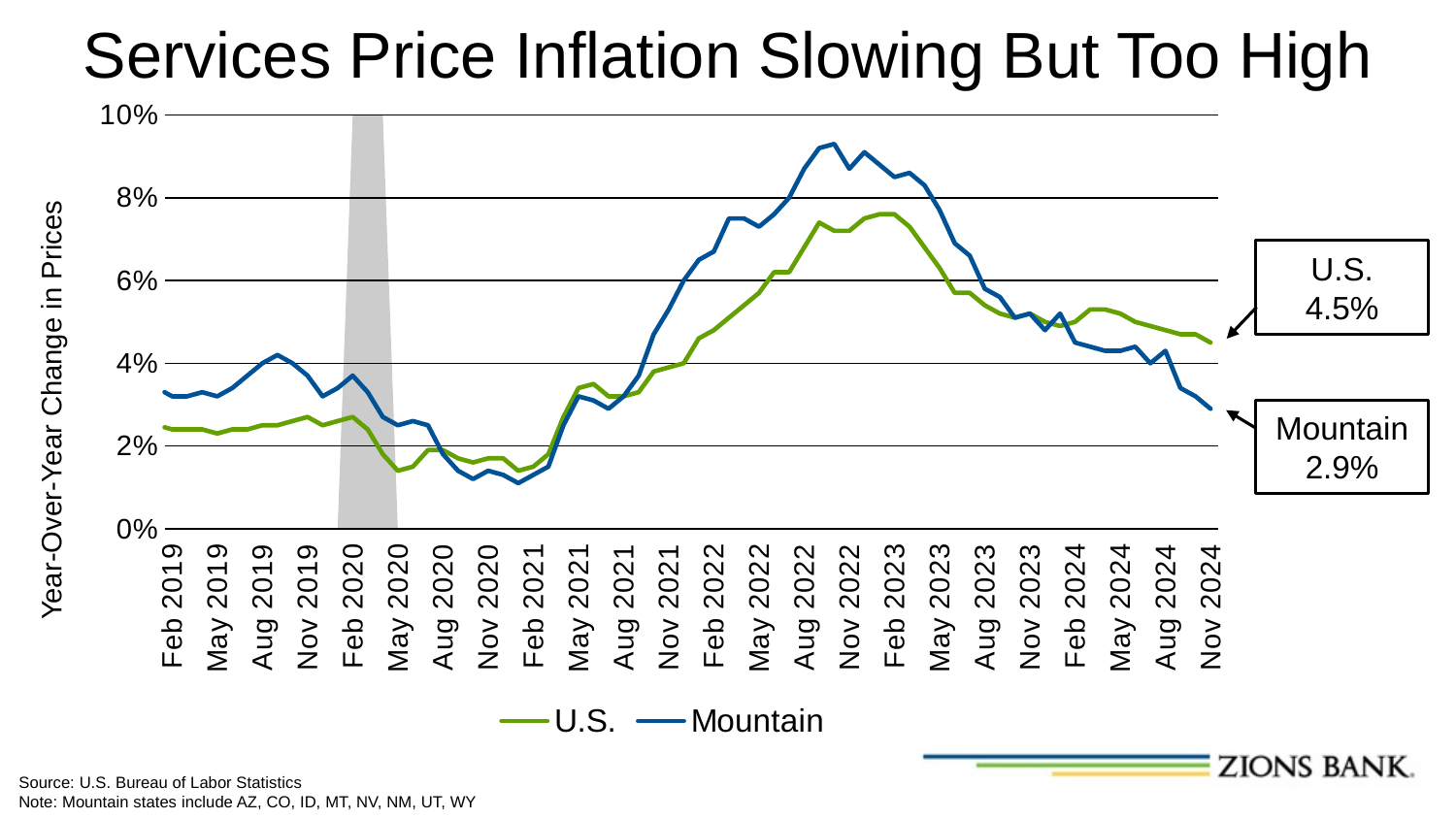
What is the Mountain year-over-year services price inflation value labeled for Nov 2024? 2.9% What kind of chart is shown on the slide? Line chart Is the peak value of the U.S. series greater or less than 8%? less What is the difference between the labeled U.S. value (4.5%) and the labeled Mountain value (2.9%) at Nov 2024? 1.6 percentage points Is the value for the Mountain series in Nov 2020 greater or less than 2%? less Which series reached the higher peak over the period shown, U.S. or Mountain? Mountain How many series does the legend list? 2 From Feb 2023 to Nov 2024, does the Mountain series generally rise or fall? Fall Is the peak value of the Mountain series greater or less than 8%? greater What is the U.S. year-over-year services price inflation value labeled for Nov 2024? 4.5% What is the title of the chart on the slide? Services Price Inflation Slowing But Too High At Nov 2024, which series has the higher value, U.S. or Mountain? U.S.